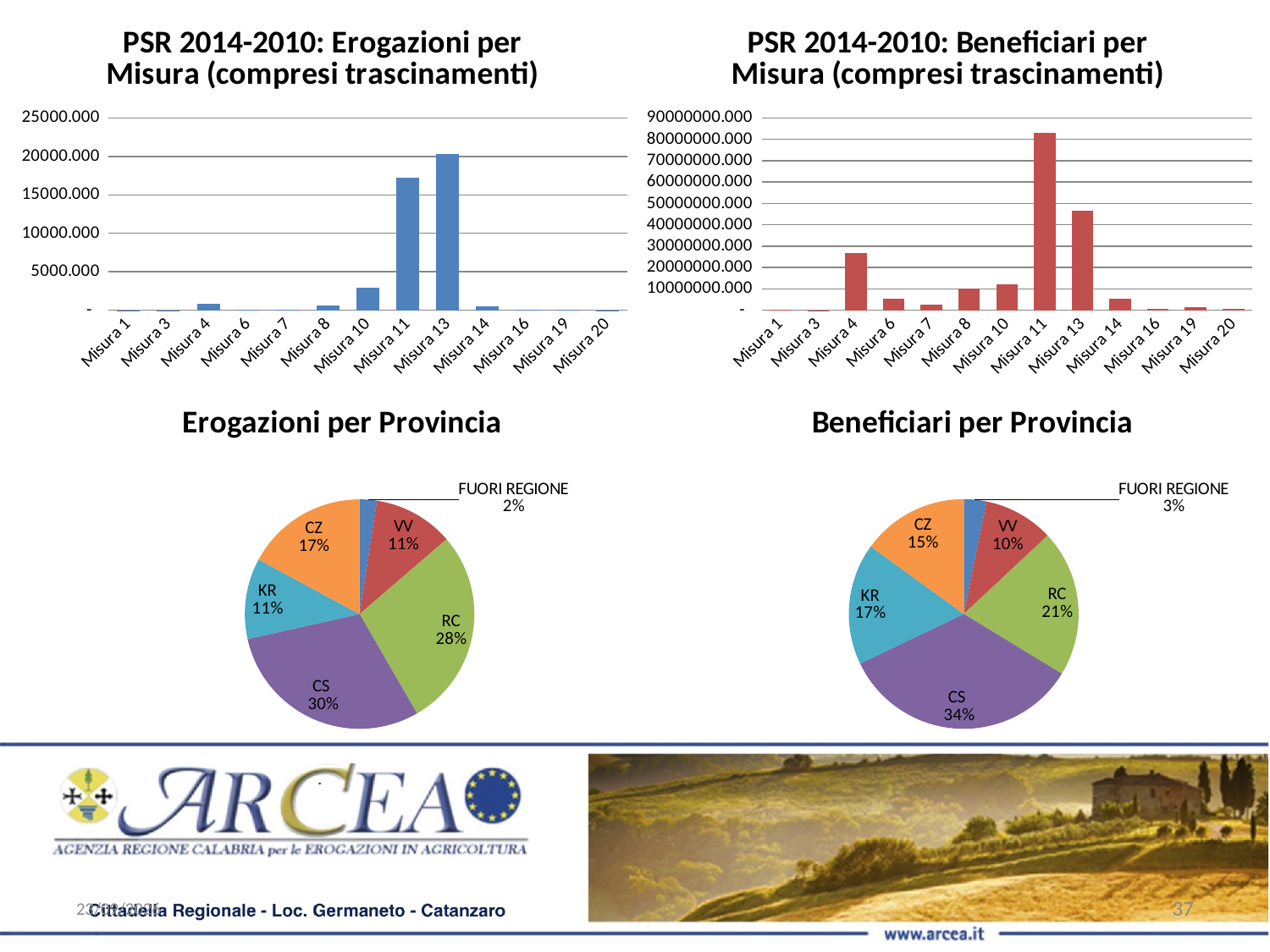
In the 'PSR 2014-2010: Beneficiari per Misura' chart, is the value for Misura 4 greater or less than 20000000.000? greater In the 'Beneficiari per Provincia' pie chart, what share does KR have? 17% In the 'PSR 2014-2010: Beneficiari per Misura' chart, which Misura has the highest value? Misura 11 In the 'Erogazioni per Provincia' pie chart, which province has the largest share? CS In the 'PSR 2014-2010: Erogazioni per Misura' chart, which Misura has the highest value? Misura 13 In the 'Beneficiari per Provincia' pie chart, what is the difference between the CS share and the RC share? 13% In the 'Erogazioni per Provincia' pie chart, what share does CS have? 30% In the 'PSR 2014-2010: Erogazioni per Misura' chart, is the value for Misura 11 greater or less than 15000.000? greater What type of chart is 'PSR 2014-2010: Beneficiari per Misura (compresi trascinamenti)'? Bar chart How many slices does the 'Erogazioni per Provincia' pie chart have? 6 In the 'Erogazioni per Provincia' pie chart, which is larger, the share for CZ or the share for VV? CZ In the 'Beneficiari per Provincia' pie chart, which slice is the smallest? FUORI REGIONE